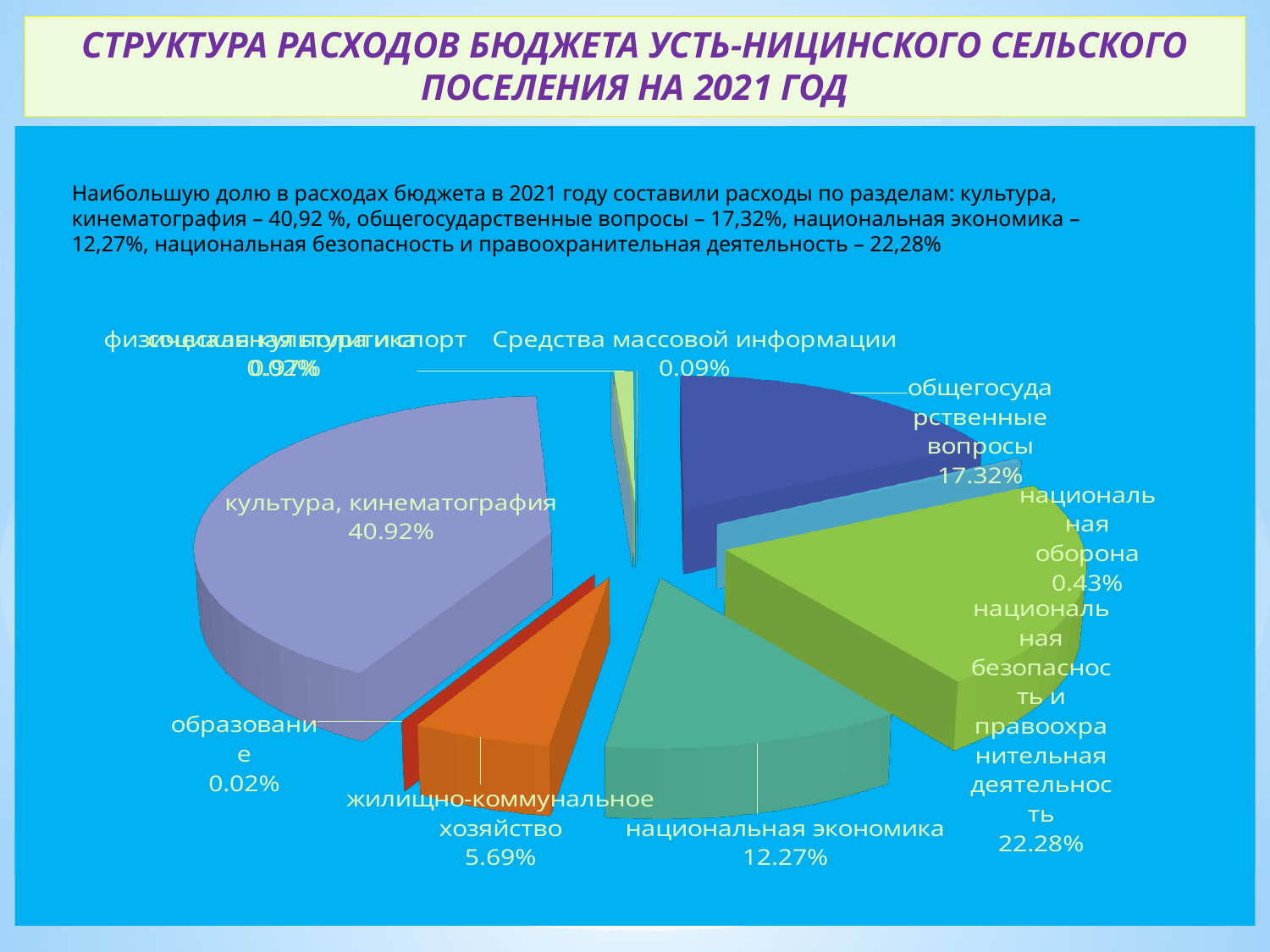
What is the value shown for общегосударственные вопросы? 17.32% What percentage is shown for национальная экономика? 12.27% What share of the budget expenditure goes to культура, кинематография? 40.92% What kind of chart is shown on the slide? pie chart What is the difference between the shares of культура, кинематография and общегосударственные вопросы? 23.60% What is the value for жилищно-коммунальное хозяйство? 5.69% What year does the chart title say the budget expenditure structure refers to? 2021 Which category has the largest share of the pie? культура, кинематография Which is larger: the share for национальная экономика or for жилищно-коммунальное хозяйство? национальная экономика What is the value shown for национальная оборона? 0.43% What share is shown for национальная безопасность и правоохранительная деятельность? 22.28%